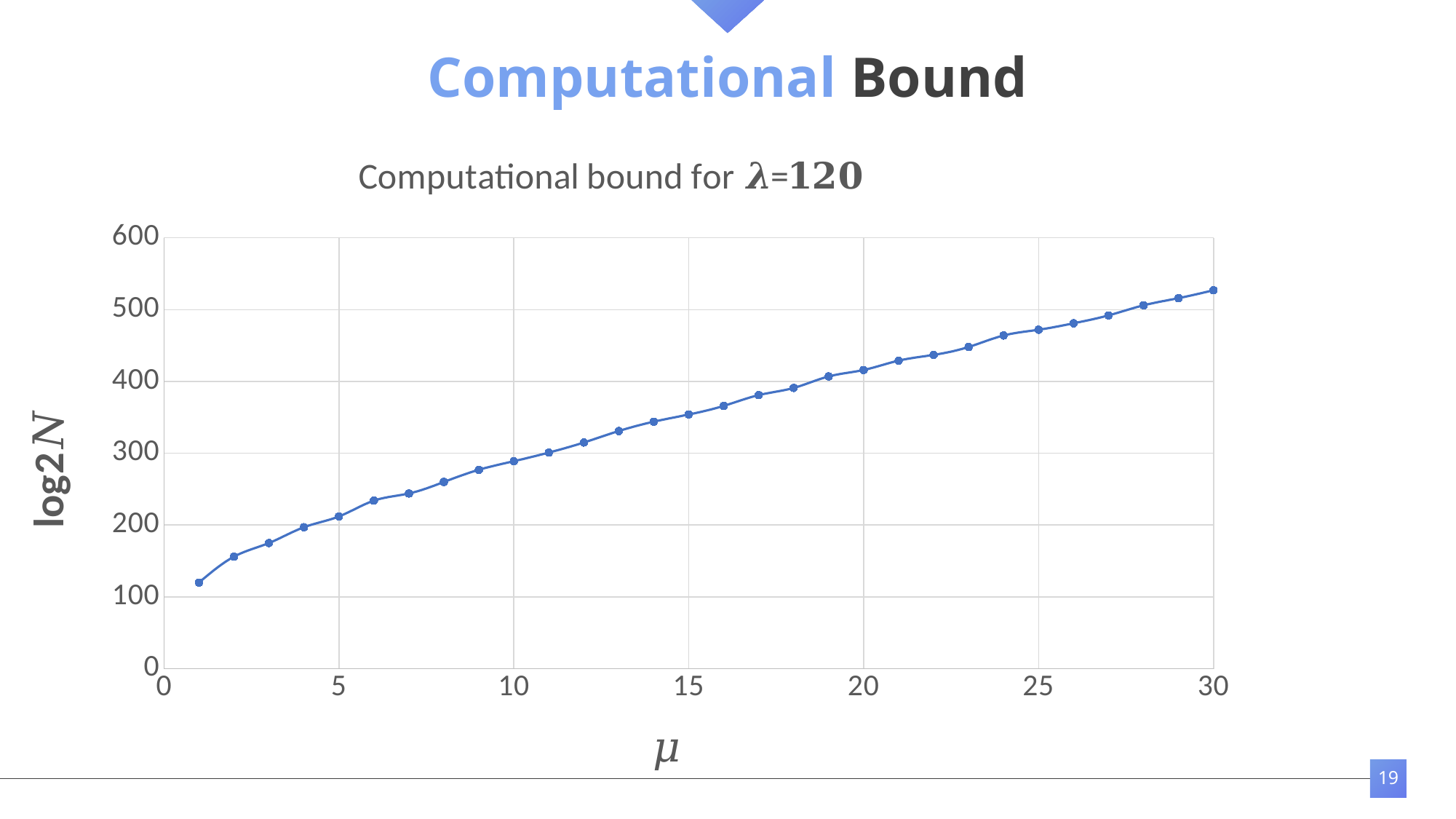
What is the label of the vertical axis? log2N Is the value of log2N at μ=10 greater or less than 300? less What kind of chart is shown on the slide? line chart At which value of μ is log2N highest? 30 At which value of μ is log2N lowest? 1 Is the value of log2N at μ=20 greater or less than 400? greater Is the value of log2N at μ=30 larger than the value at μ=15? yes What is the title of the chart? Computational bound for λ=120 Is the value of log2N at μ=1 greater or less than 100? greater Do the values rise or fall as μ increases along the x axis? rise